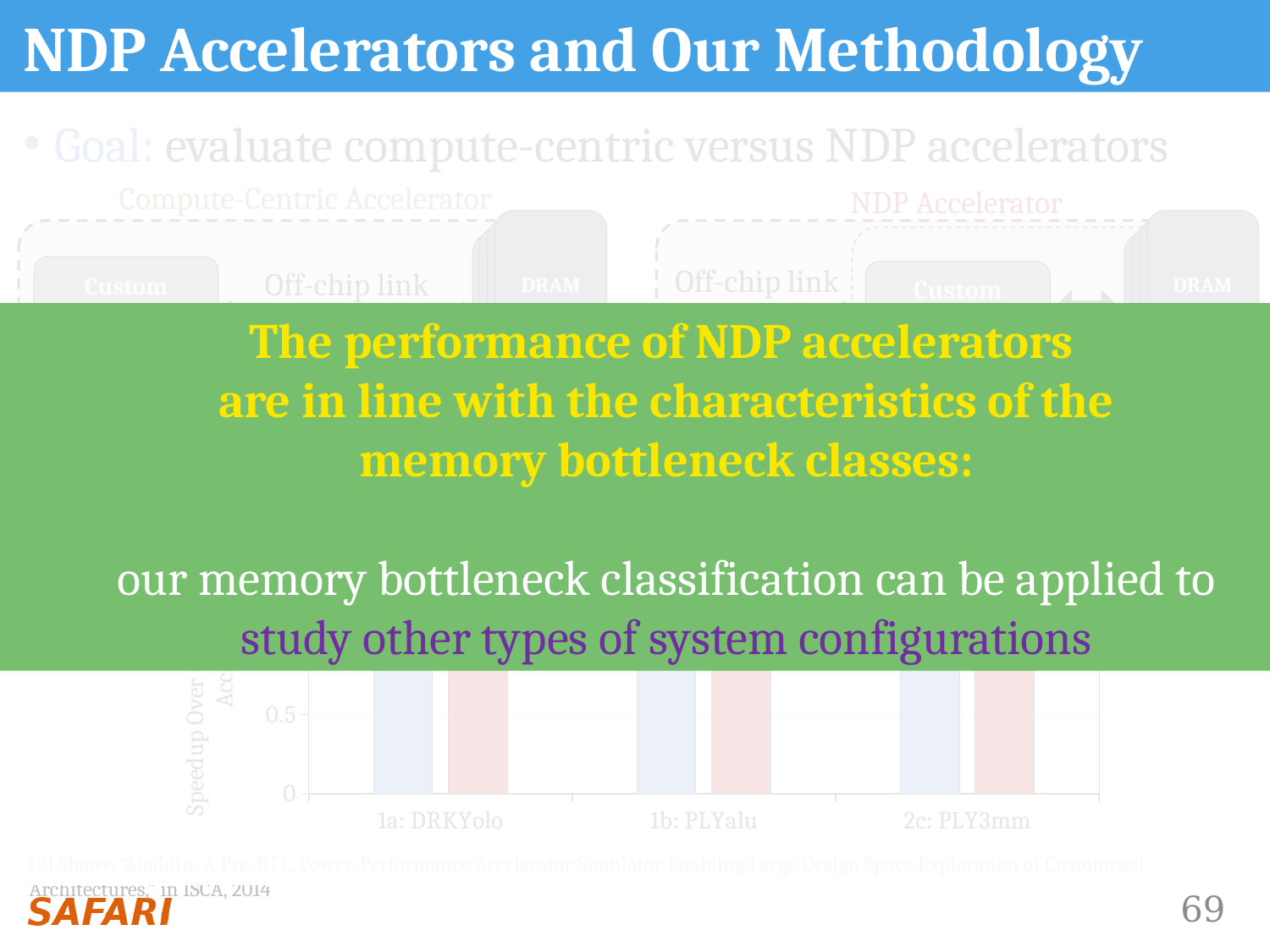
Are the bars for 2c: PLY3mm greater or less than 0.5? greater Are the bars for 1a: DRKYolo greater or less than 0.5? greater What is the label of the first category on the x axis of the chart? 1a: DRKYolo How many categories are shown on the x axis of the chart? 3 Are the bars for 1b: PLYalu greater or less than 0.5? greater What kind of chart is shown at the bottom of the slide? bar chart What is the label of the last category on the x axis of the chart? 2c: PLY3mm How many bars are drawn for each category in the chart? 2